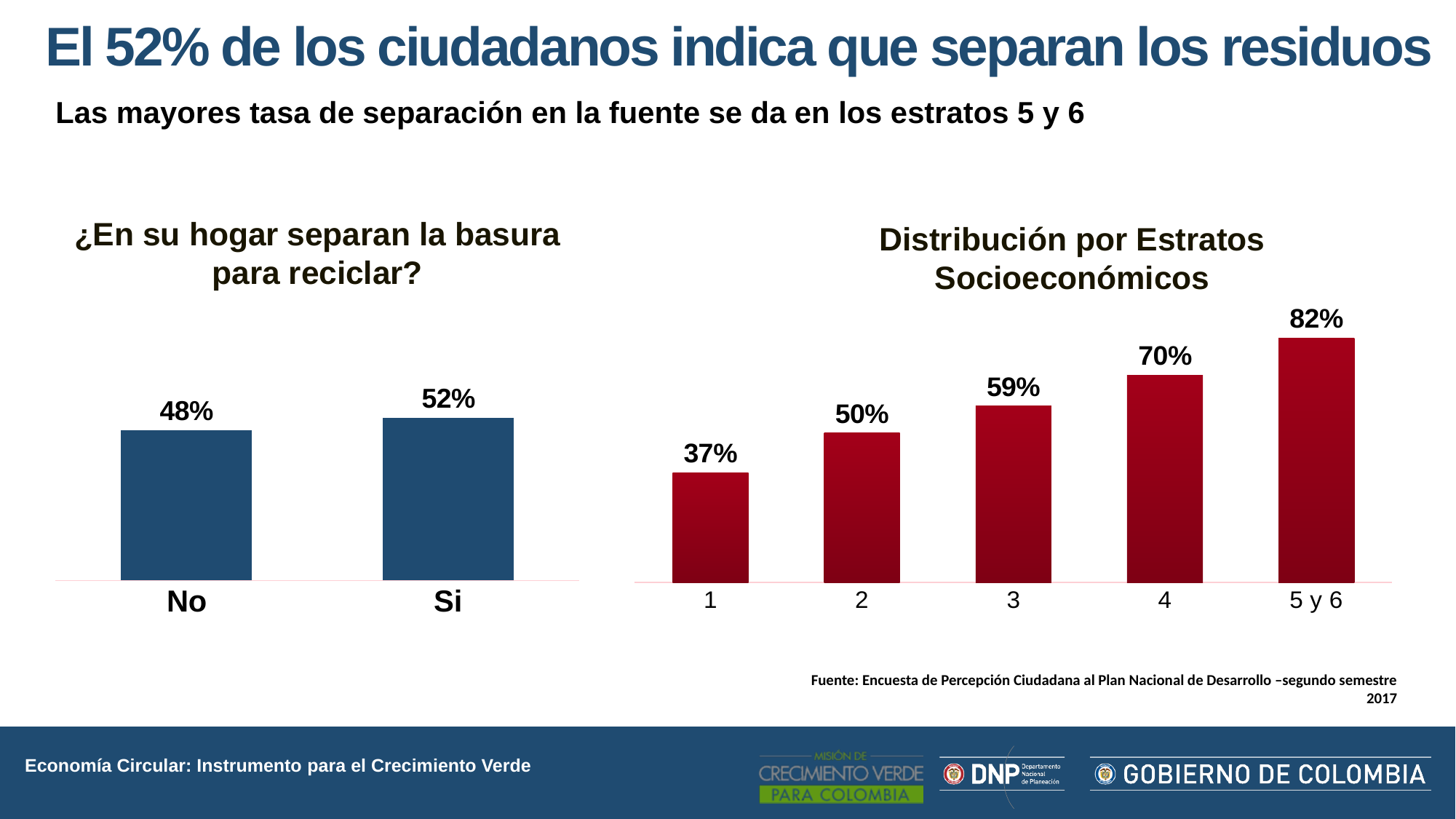
In the chart titled '¿En su hogar separan la basura para reciclar?', what is the value for 'No'? 48% In the chart titled '¿En su hogar separan la basura para reciclar?', what is the value for 'Si'? 52% In the chart titled '¿En su hogar separan la basura para reciclar?', what is the difference between 'Si' and 'No'? 4% In the chart titled '¿En su hogar separan la basura para reciclar?', how many categories are shown? 2 In the chart titled 'Distribución por Estratos Socioeconómicos', what is the value for estrato 3? 59% In the chart titled 'Distribución por Estratos Socioeconómicos', what is the value for estrato '5 y 6'? 82% In the chart titled 'Distribución por Estratos Socioeconómicos', which category has the highest value? 5 y 6 In the chart titled 'Distribución por Estratos Socioeconómicos', which category has the lowest value? 1 What kind of chart is the chart titled 'Distribución por Estratos Socioeconómicos'? bar chart In the chart titled 'Distribución por Estratos Socioeconómicos', which is larger, estrato 2 or estrato 4? 4 In the chart titled 'Distribución por Estratos Socioeconómicos', what is the difference between estrato '5 y 6' and estrato 1? 45% In the chart titled 'Distribución por Estratos Socioeconómicos', do the values rise or fall from estrato 1 to estrato '5 y 6'? rise